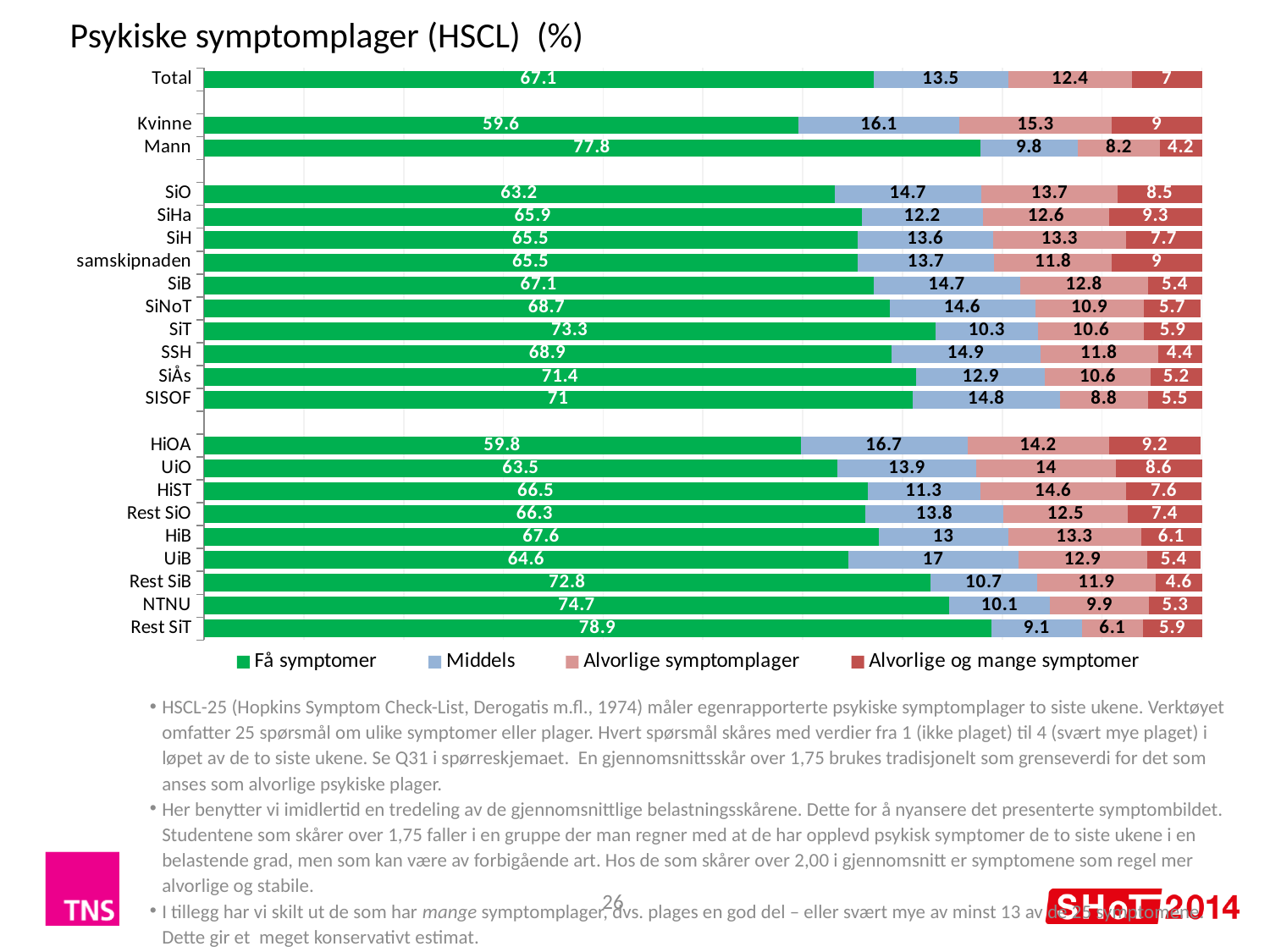
How many series does the legend list? 4 How many categories are shown on the chart? 22 Which category has the highest Få symptomer value? Rest SiT What is the Middels value for Kvinne? 16.1 Which has the larger Alvorlige og mange symptomer value, Kvinne or Mann? Kvinne What is the difference between the Få symptomer values for Mann and Kvinne? 18.2 What is the value of Få symptomer for Mann? 77.8 Which category has the lowest Få symptomer value? Kvinne What kind of chart is shown on the slide? Stacked bar chart What is the value of Alvorlige og mange symptomer for SiHa? 9.3 What is the total of the stacked bar for Total? 100 What is the Alvorlige symptomplager value for HiST? 14.6